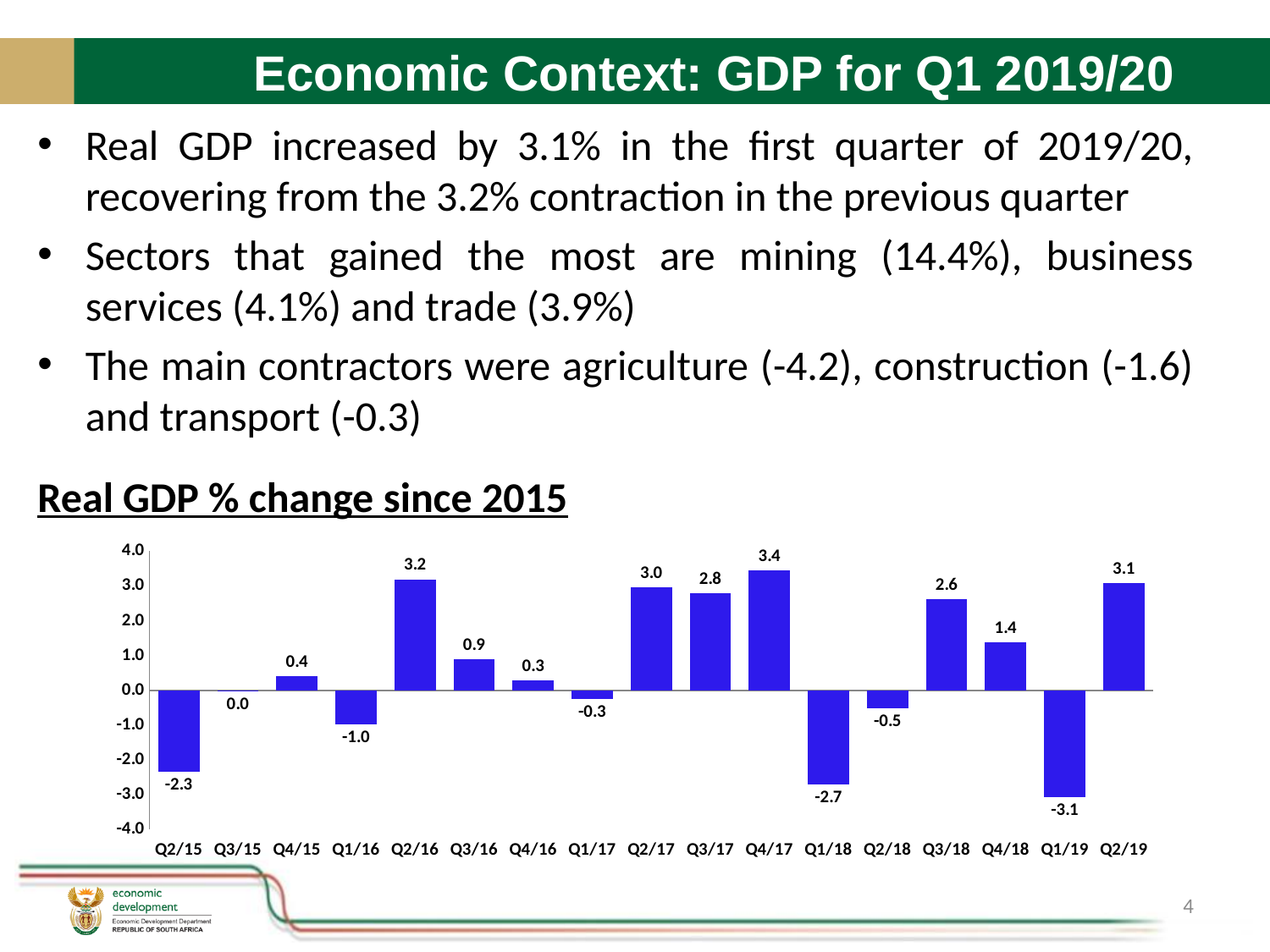
What is the title of the chart? Real GDP % change since 2015 Which quarter has the lowest real GDP % change? Q1/19 Is the value for Q1/18 greater or less than -2.0? less How many quarters are shown on the x axis? 17 What is the value shown for Q1/19? -3.1 What is the value shown for Q3/15? 0.0 Which quarter has the highest real GDP % change? Q4/17 What kind of chart is shown on the slide? bar chart What is the value shown for Q4/18? 1.4 Which is larger, the value for Q2/17 or the value for Q3/17? Q2/17 What is the real GDP % change for Q2/16? 3.2 What is the difference between the values for Q2/19 and Q1/19? 6.2